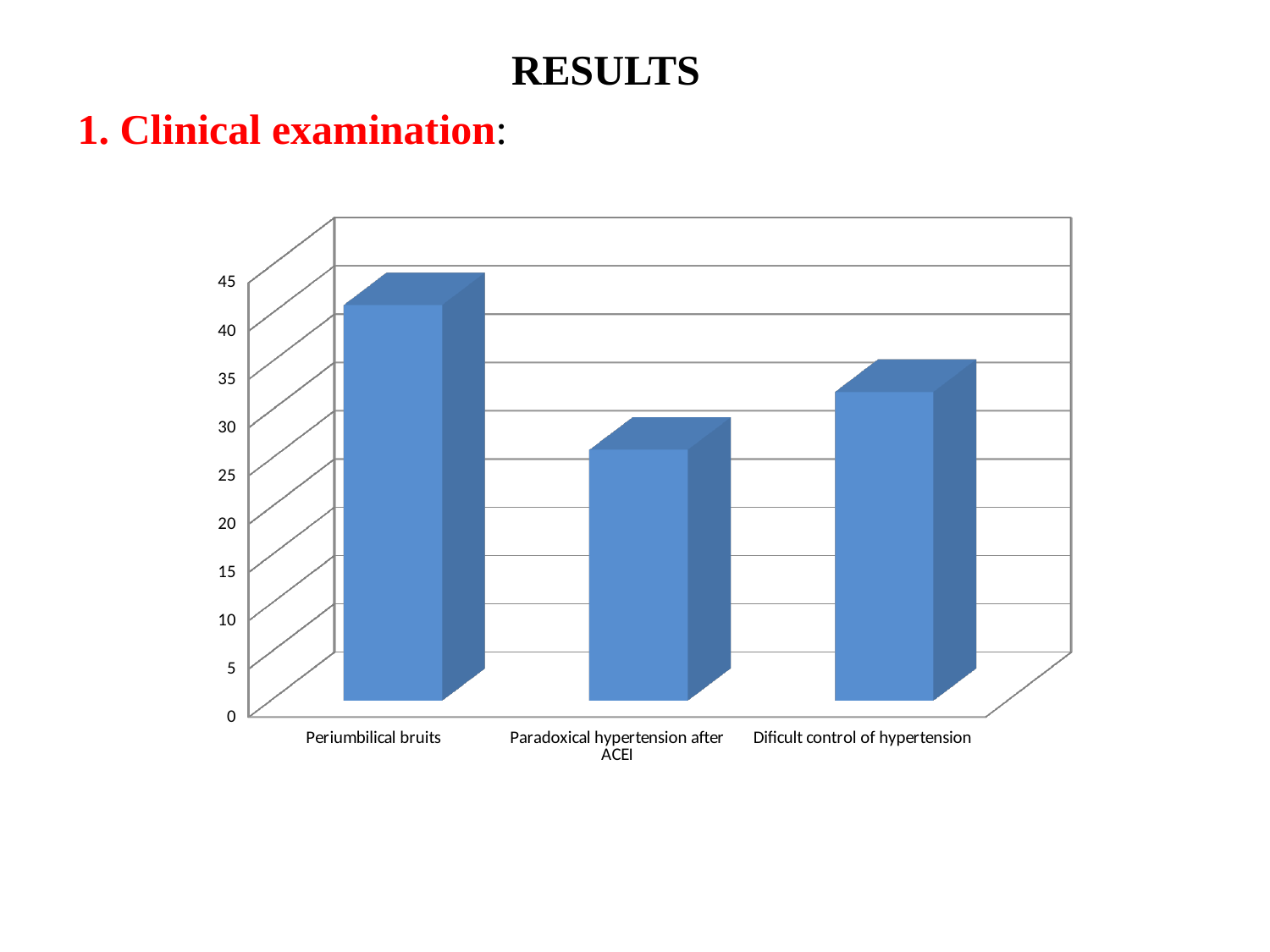
Which is larger, the value for Paradoxical hypertension after ACEI or the value for Dificult control of hypertension? Dificult control of hypertension Which category has the lowest bar? Paradoxical hypertension after ACEI Is the value for Paradoxical hypertension after ACEI greater or less than 35? less What kind of chart is shown on the slide? bar chart What is the highest tick value shown on the vertical axis? 45 How many categories are plotted in the chart? 3 Which category has the highest bar? Periumbilical bruits Is the value for Dificult control of hypertension greater or less than 25? greater Is the value for Periumbilical bruits greater or less than 35? greater Which is larger, the value for Periumbilical bruits or the value for Dificult control of hypertension? Periumbilical bruits